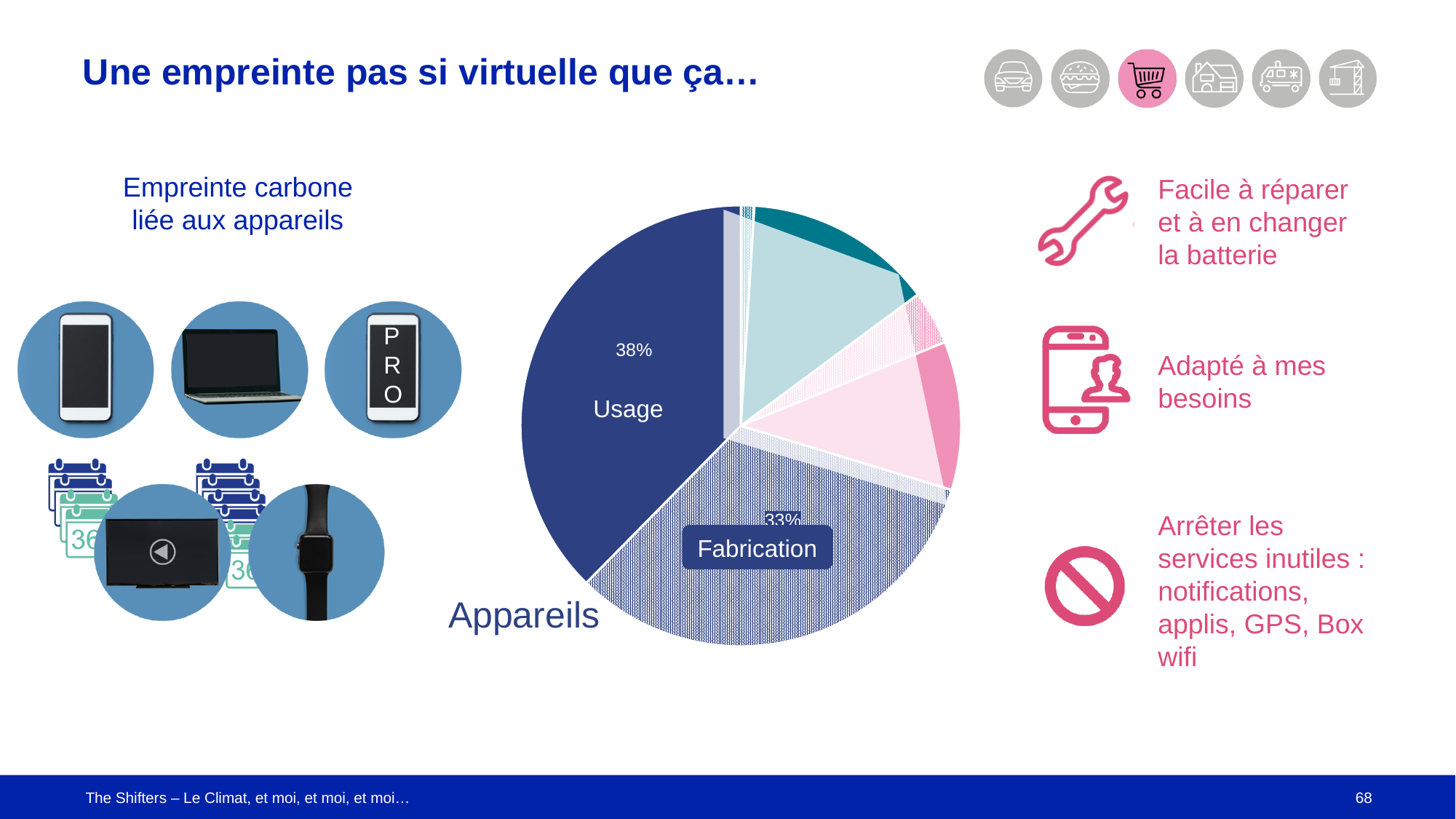
What word is written in large text at the bottom left of the pie chart? Appareils What is the combined share of the Usage and Fabrication slices? 71% What is the title given to the chart on the left side of the slide? Empreinte carbone liée aux appareils What percentage does the Fabrication slice of the pie chart represent? 33% What kind of chart is shown on the slide? Pie chart What percentage does the Usage slice of the pie chart represent? 38% What is the difference in percentage points between the Usage slice and the Fabrication slice? 5 percentage points Which labelled slice is the largest in the pie chart? Usage Which slice is larger in the pie chart, Usage or Fabrication? Usage